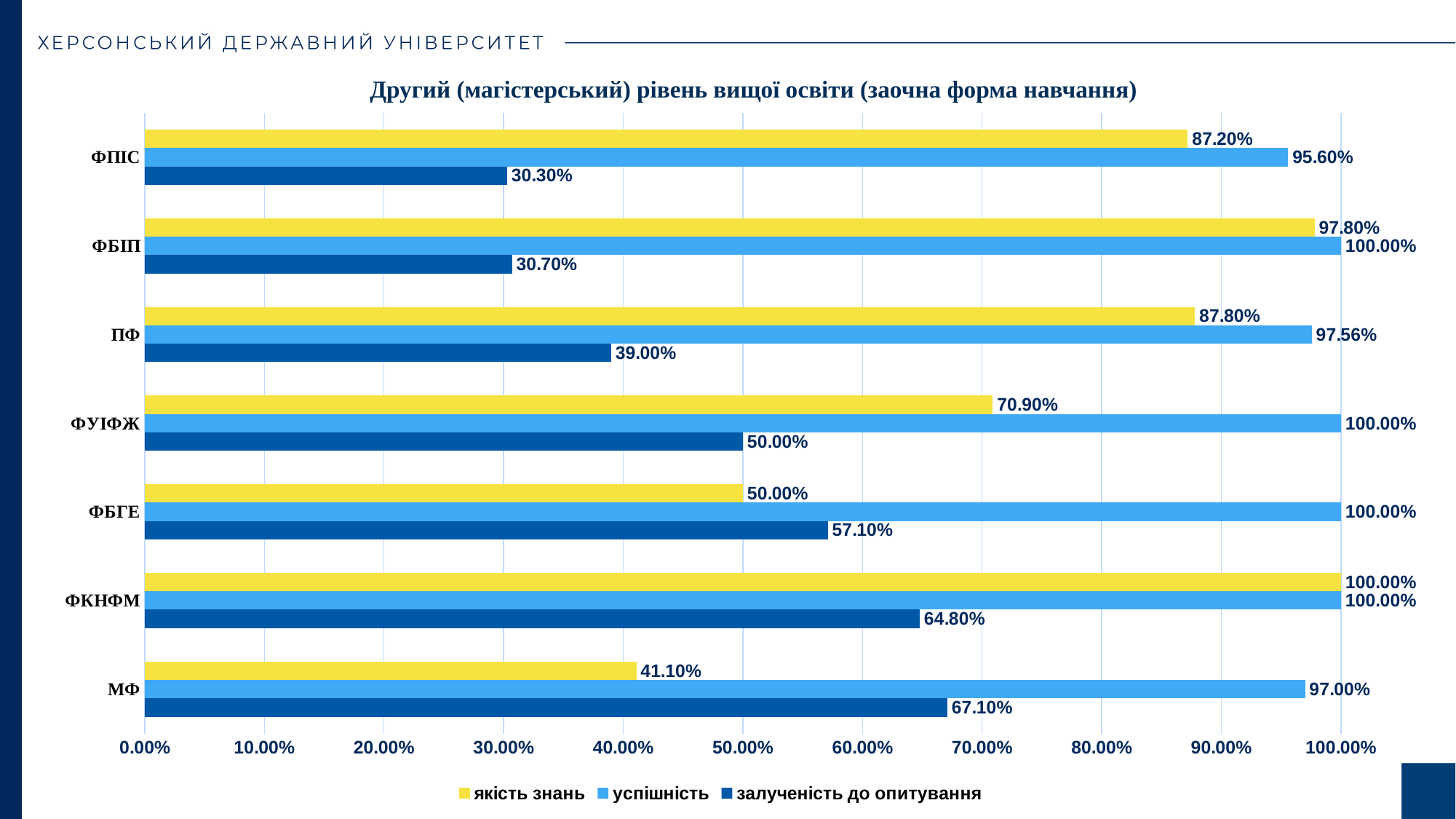
Which category has the lowest value for залученість до опитування? ФПІС What is the value of якість знань for ФПІС? 87.20% Which is larger for ФБГЕ: якість знань or залученість до опитування? залученість до опитування How many series does the legend list? 3 What is the title of the chart? Другий (магістерський) рівень вищої освіти (заочна форма навчання) Which category has the lowest value for якість знань? МФ What is the value of успішність for МФ? 97.00% What is the value of залученість до опитування for ПФ? 39.00% What kind of chart is shown on the slide? bar chart What is the difference between успішність and залученість до опитування for ФБІП? 69.30% Which category has the highest value for залученість до опитування? МФ How many categories are shown on the chart? 7